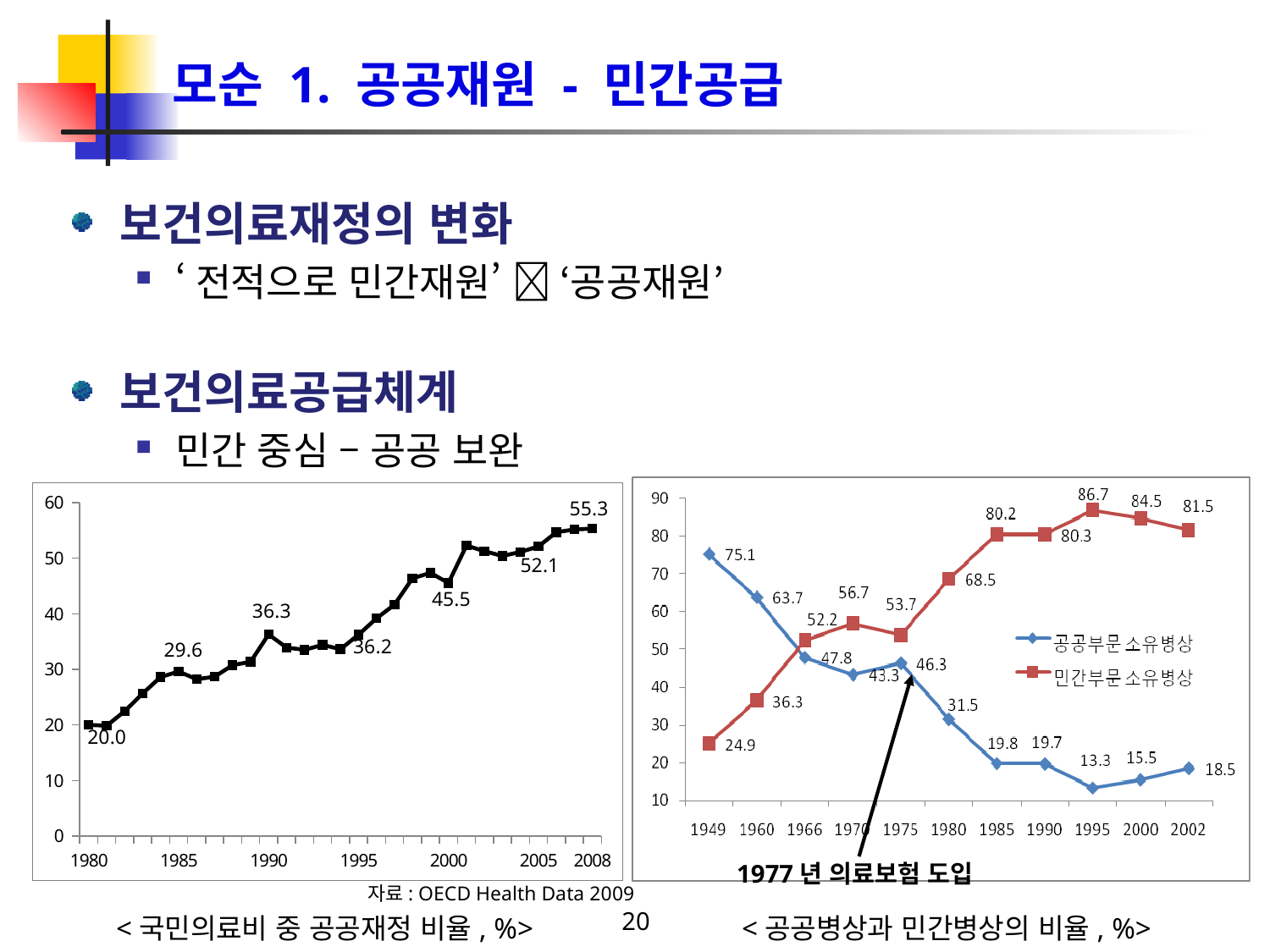
How many years are plotted on the x axis of the right chart (공공병상과 민간병상의 비율)? 11 In the right chart (공공병상과 민간병상의 비율), what is the value of 공공부문 소유병상 in 1949? 75.1 In the right chart (공공병상과 민간병상의 비율), in which year is 민간부문 소유병상 highest? 1995 In the left chart (국민의료비 중 공공재정 비율), do the values generally rise or fall from 1980 to 2008? rise In the right chart (공공병상과 민간병상의 비율), in which year is 공공부문 소유병상 lowest? 1995 In the right chart (공공병상과 민간병상의 비율), what is the value of 민간부문 소유병상 in 1995? 86.7 In the left chart (국민의료비 중 공공재정 비율), what is the difference between the 2008 value and the 1980 value? 35.3 In the left chart (국민의료비 중 공공재정 비율), what is the value for 1980? 20.0 How many series does the legend of the right chart (공공병상과 민간병상의 비율) list? 2 In the left chart (국민의료비 중 공공재정 비율), what is the value for 2008? 55.3 What kind of chart is the left chart (국민의료비 중 공공재정 비율)? line chart In the right chart (공공병상과 민간병상의 비율), which series has the larger value in 1966, 공공부문 소유병상 or 민간부문 소유병상? 민간부문 소유병상